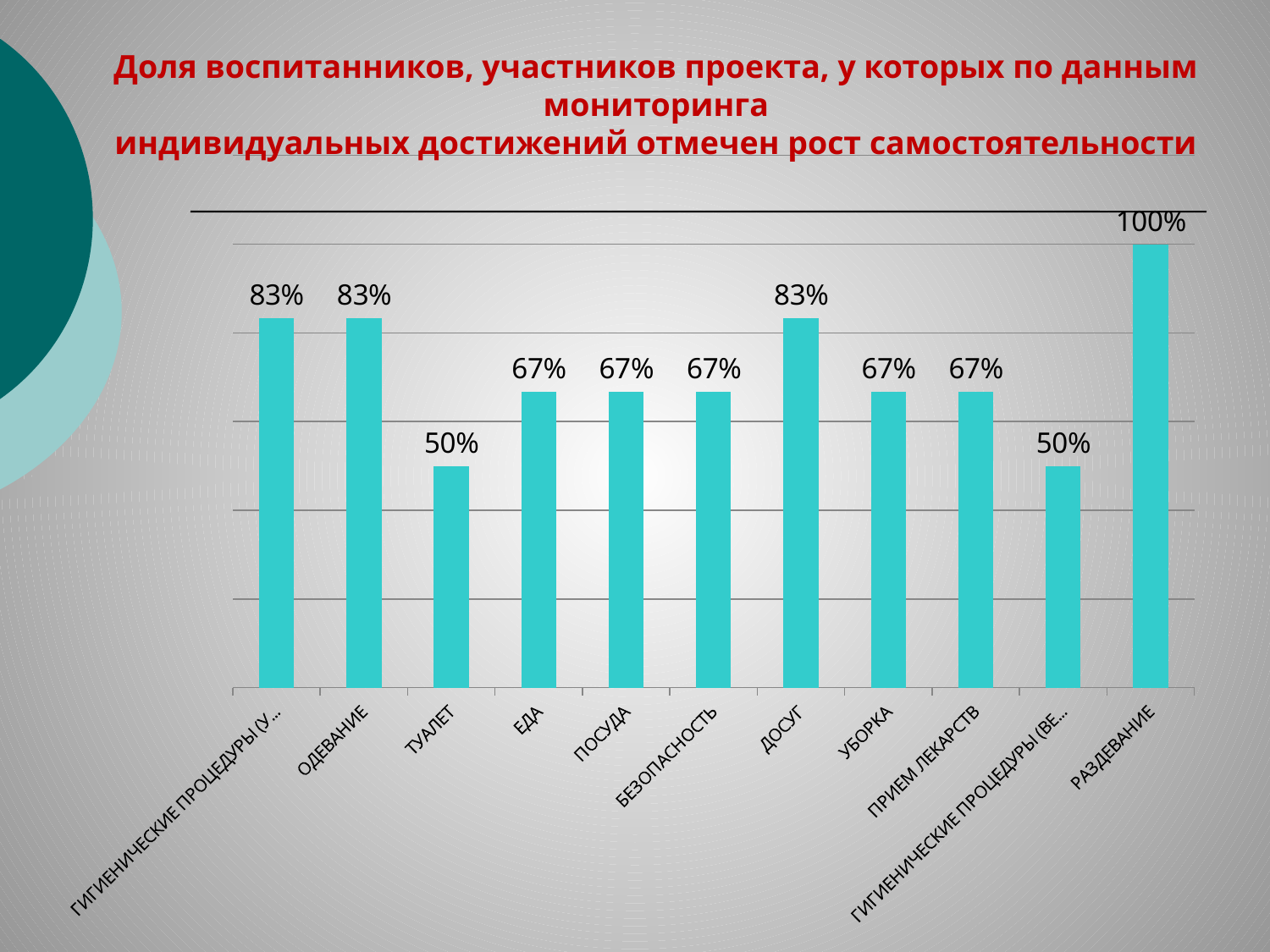
Which category has the highest value? РАЗДЕВАНИЕ What is the value for ТУАЛЕТ? 50% What type of chart is shown on the slide? bar chart Which is larger, the value for ЕДА or the value for ОДЕВАНИЕ? ОДЕВАНИЕ How many categories (bars) does the chart show? 11 What is the value for ПОСУДА? 67% What is the difference between the values for РАЗДЕВАНИЕ and ТУАЛЕТ? 50% What is the value for ОДЕВАНИЕ? 83% What is the value for ДОСУГ? 83% What colour are the bars in the chart? turquoise (cyan) What is the value for РАЗДЕВАНИЕ? 100% What is the difference between the values for ДОСУГ and УБОРКА? 16%